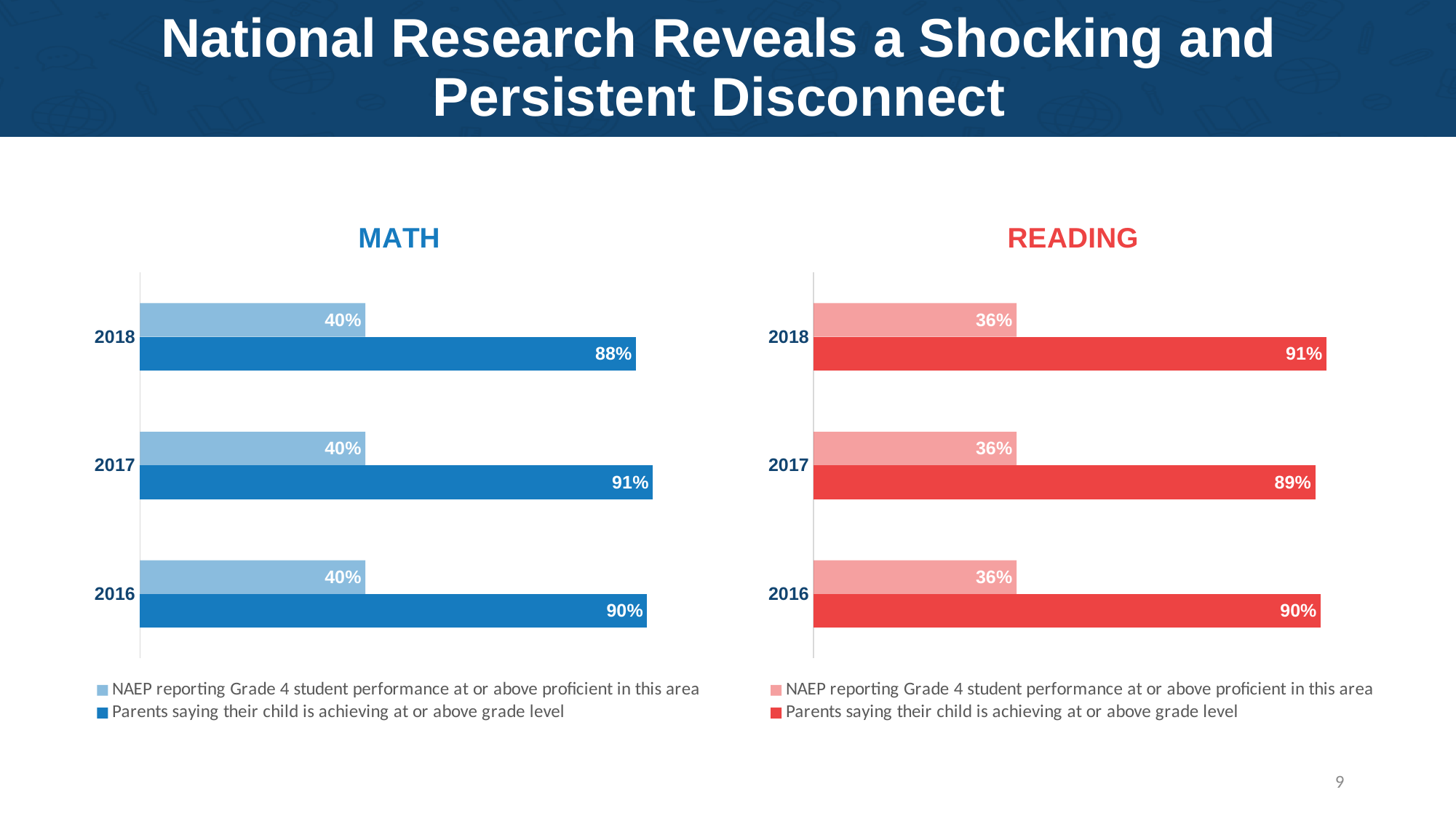
In the READING chart, which year has the lowest value for parents saying their child is achieving at or above grade level? 2017 In the MATH chart, what is the difference between the parents' value and the NAEP value for 2016? 50 percentage points In the READING chart, what percentage of parents said their child is achieving at or above grade level in 2016? 90% In the READING chart, what is the NAEP reported Grade 4 proficiency value for 2017? 36% In the MATH chart, what percentage of parents said their child is achieving at or above grade level in 2018? 88% How many years are shown on the x axis of the READING chart? 3 In the MATH chart, does the NAEP value rise, fall, or stay the same from 2016 to 2018? Stays the same In the MATH chart, which year has the highest value for parents saying their child is achieving at or above grade level? 2017 How many series does the legend of the MATH chart list? 2 In the READING chart, what is the difference between the parents' value and the NAEP value for 2018? 55 percentage points What type of chart is the READING chart? Bar chart In the MATH chart, which is larger in 2017: the NAEP value or the parents' value? Parents saying their child is achieving at or above grade level